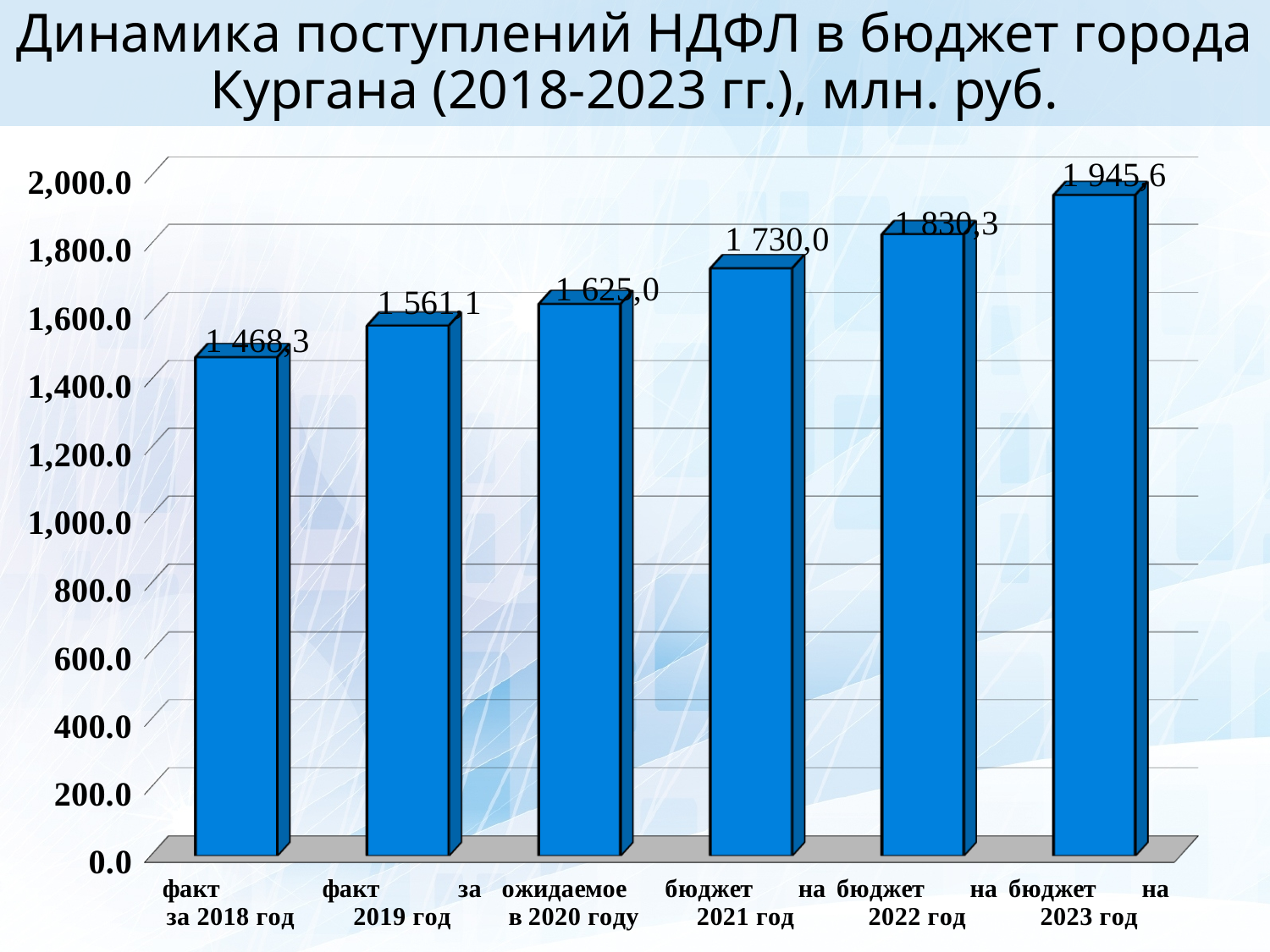
Which category has the lowest value? факт за 2018 год What is the value for бюджет на 2021 год? 1 730,0 What kind of chart is shown on the slide? bar chart What is the difference between the values for бюджет на 2022 год and бюджет на 2021 год? 100,3 How many bars are shown in the chart? 6 Is the value for бюджет на 2022 год greater or less than 1,800.0? greater What is the difference between the values for бюджет на 2023 год and факт за 2018 год? 477,3 What is the value for ожидаемое в 2020 году? 1 625,0 Which category has the highest value? бюджет на 2023 год Do the values rise or fall from 2018 to 2023? rise What is the value for факт за 2018 год? 1 468,3 Which is larger, the value for факт за 2019 год or the value for ожидаемое в 2020 году? ожидаемое в 2020 году